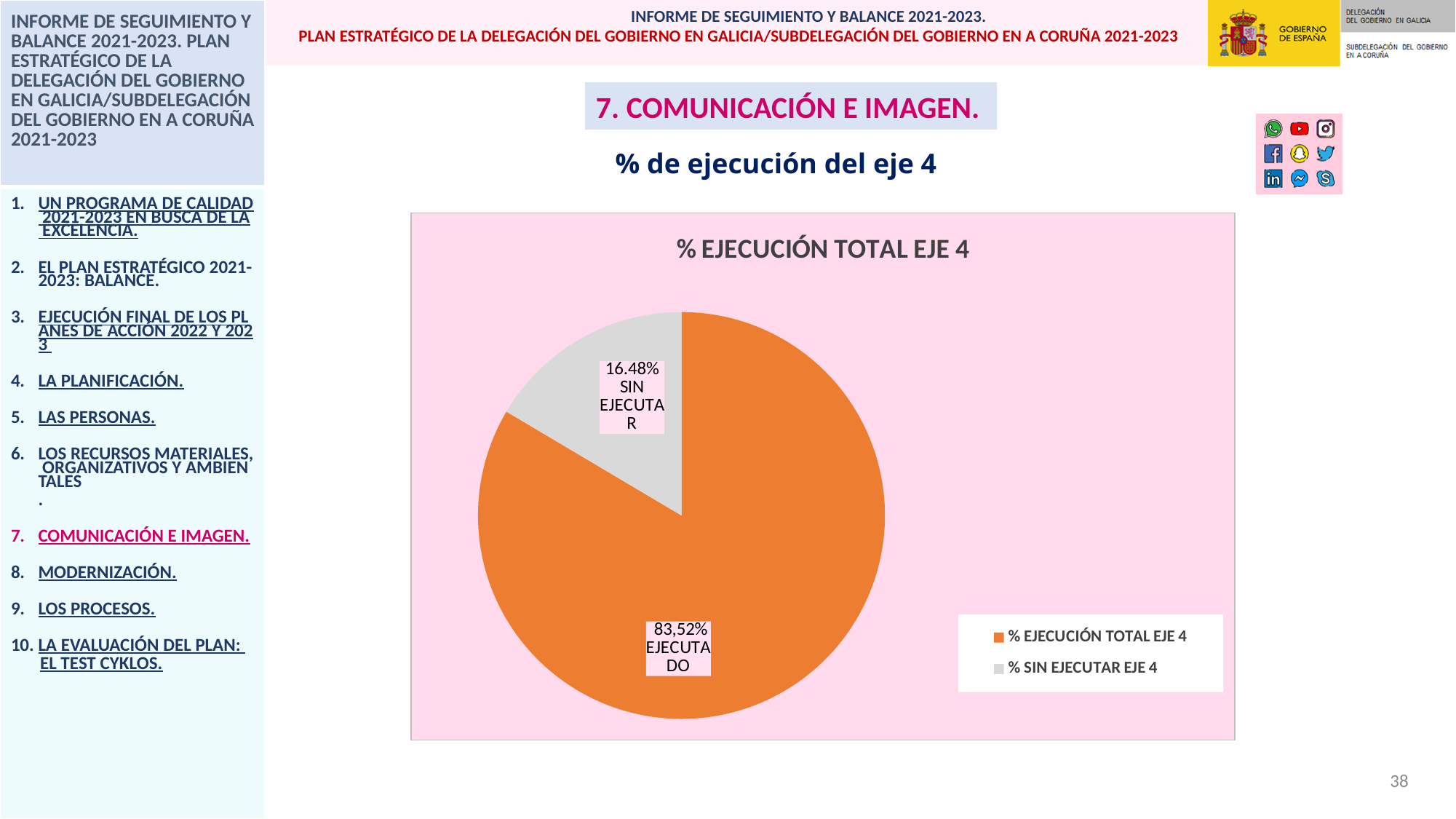
Which slice is the largest in the pie chart? EJECUTADO What percentage is shown for the EJECUTADO slice? 83,52% How many slices does the pie chart have? 2 How many entries does the legend list? 2 Which slice is the smallest in the pie chart? SIN EJECUTAR Is the value for SIN EJECUTAR greater or less than 20%? less What percentage is shown for the SIN EJECUTAR slice? 16.48% What colour is the % EJECUCIÓN TOTAL EJE 4 slice? orange What type of chart is shown on the slide? pie chart Which is larger, the EJECUTADO slice or the SIN EJECUTAR slice? EJECUTADO What is the title of the chart? % EJECUCIÓN TOTAL EJE 4